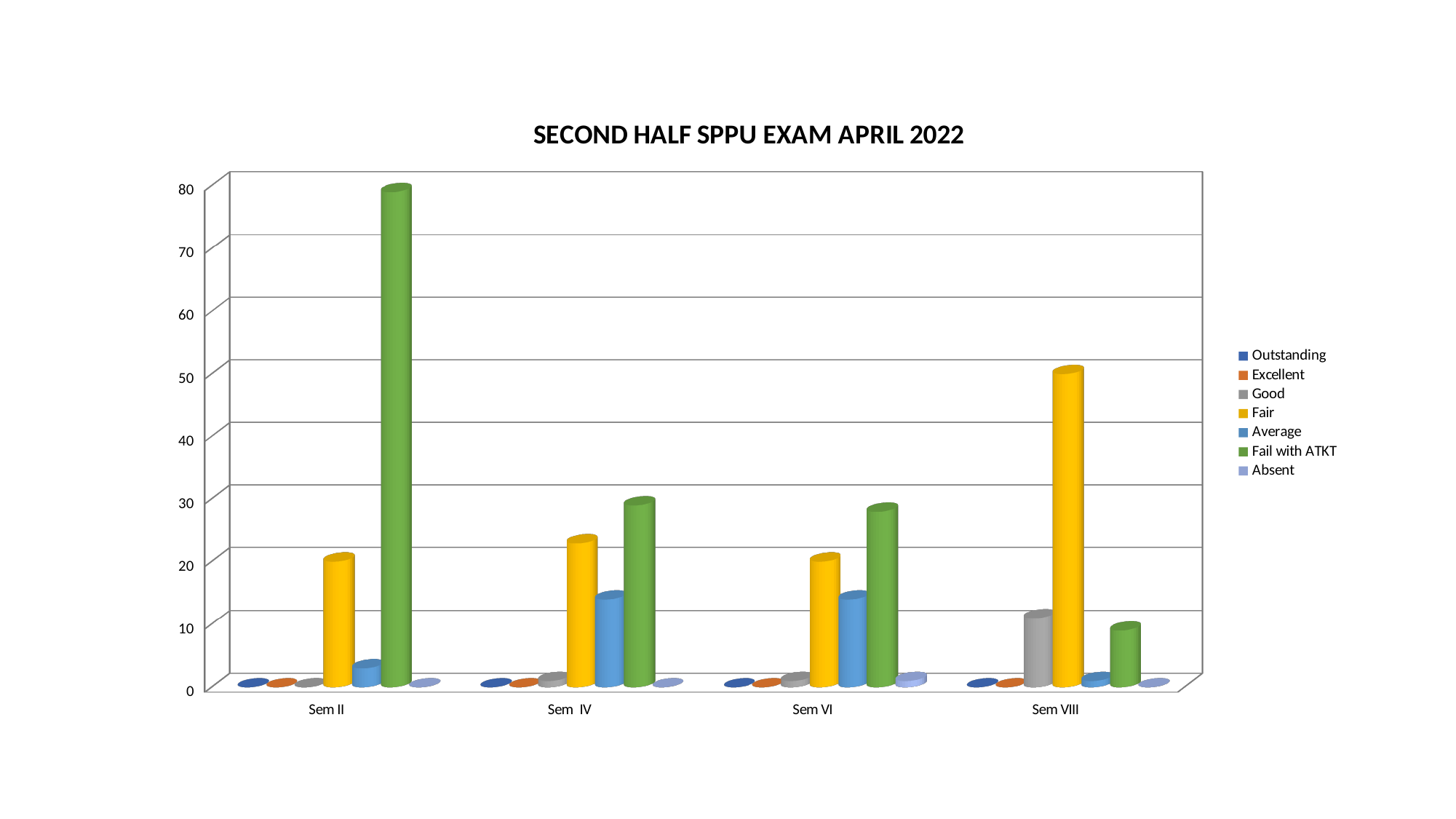
Which semester has the highest Fail with ATKT value? Sem II Which semester has the highest Fair value? Sem VIII Which semester has the lowest Fail with ATKT value? Sem VIII Is the Fair value for Sem VIII greater or less than 40? greater In Sem VIII, which is larger: the Fair value or the Fail with ATKT value? Fair What kind of chart is shown on the slide? bar chart Is the Average value for Sem IV greater or less than 10? greater What is the title of the chart? SECOND HALF SPPU EXAM APRIL 2022 Is the Fail with ATKT value for Sem II greater or less than 70? greater How many semester categories are shown on the x axis? 4 How many series does the legend list? 7